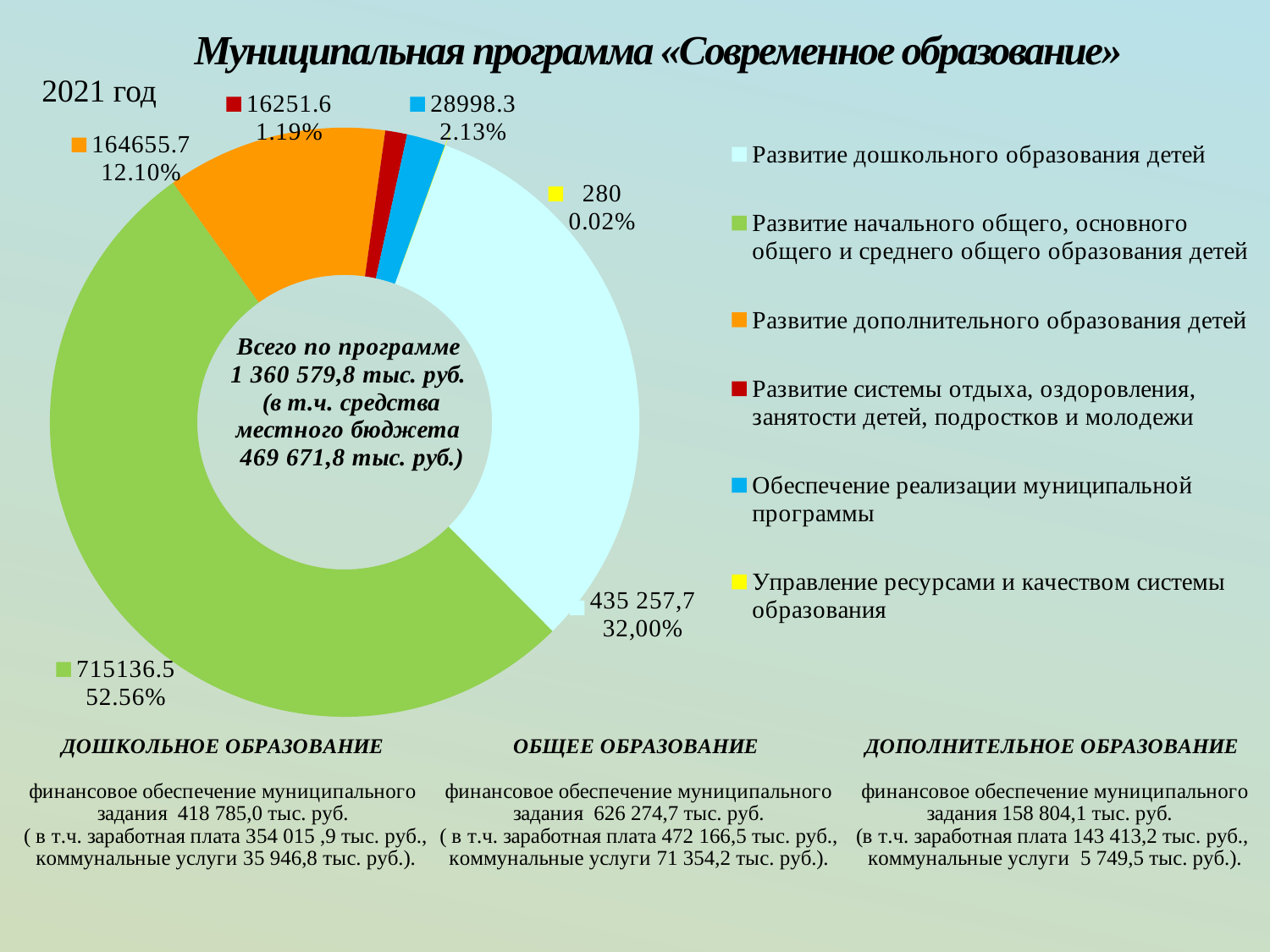
What percentage share is shown for «Развитие дошкольного образования детей»? 32,00% How many categories does the legend of the chart list? 6 Which category has the largest share of the chart? Развитие начального общего, основного общего и среднего общего образования детей Which is larger: the value for «Развитие системы отдыха, оздоровления, занятости детей, подростков и молодежи» or for «Обеспечение реализации муниципальной программы»? Обеспечение реализации муниципальной программы What kind of chart is shown on the slide? doughnut (pie) chart What is the value shown for «Развитие начального общего, основного общего и среднего общего образования детей»? 715136.5 Which category has the smallest share of the chart? Управление ресурсами и качеством системы образования What is the value shown for «Управление ресурсами и качеством системы образования»? 280 What colour is the slice for «Развитие дополнительного образования детей»? orange What percentage share is shown for «Обеспечение реализации муниципальной программы»? 2.13% What is the difference between the values for «Развитие дополнительного образования детей» and «Развитие системы отдыха, оздоровления, занятости детей, подростков и молодежи»? 148404.1 What is the value shown for «Развитие дополнительного образования детей»? 164655.7